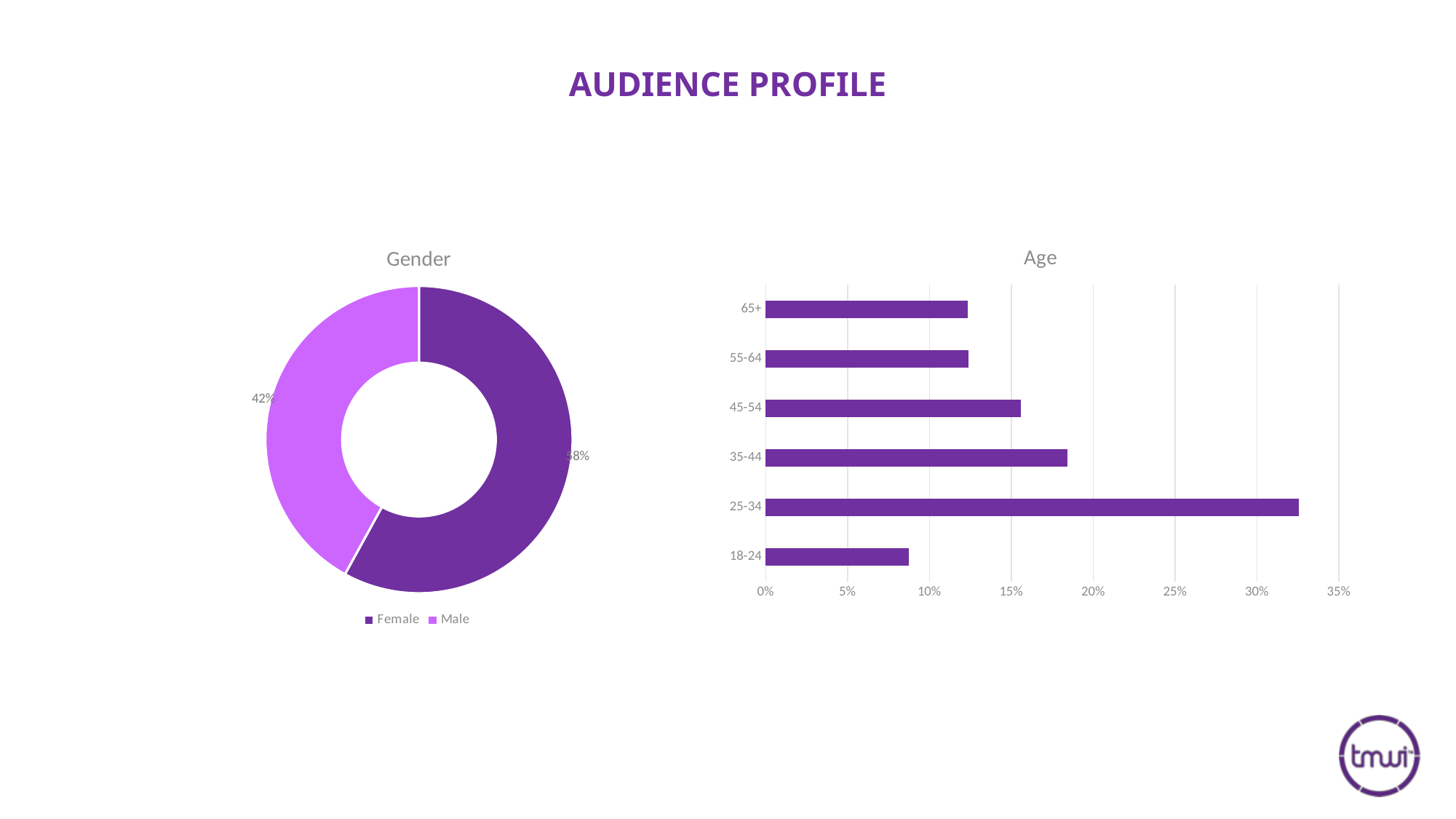
In the Gender chart, what percentage of the audience is Female? 58% In the Gender chart, what is the difference in percentage points between the Female and Male shares? 16 percentage points In the Age chart, is the value for 25-34 greater or less than 30%? greater In the Age chart, which age group has the highest value? 25-34 In the Gender chart, which is larger, the Female share or the Male share? Female In the Age chart, which age group has the lowest value? 18-24 How many entries does the legend of the Gender chart list? 2 How many age groups are shown in the Age chart? 6 In the Gender chart, what percentage of the audience is Male? 42% In the Age chart, is the value for 18-24 greater or less than 10%? less What kind of chart is the Gender chart? Donut (pie) chart What kind of chart is the Age chart? Bar chart